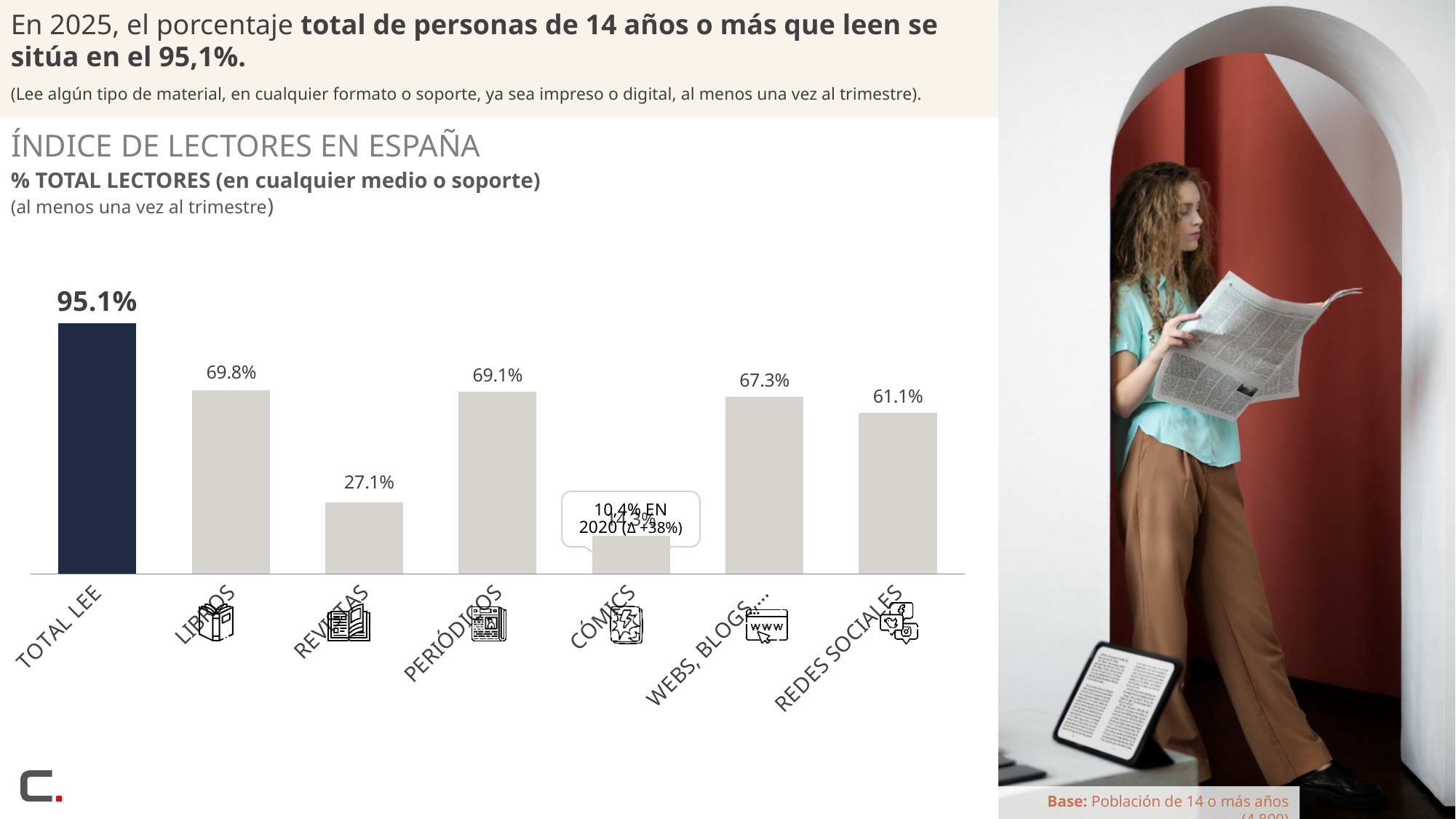
What type of chart is shown on the slide? bar chart Which category has the lowest value? CÓMICS What is the value for REVISTAS? 27.1% How many categories are shown in the chart? 7 What is the value for LIBROS? 69.8% What is the title of the chart? ÍNDICE DE LECTORES EN ESPAÑA What is the value for TOTAL LEE? 95.1% What is the difference between the values for LIBROS and REDES SOCIALES? 8.7% What is the value for PERIÓDICOS? 69.1% Which is larger, the value for WEBS, BLOGS... or the value for REVISTAS? WEBS, BLOGS... Which category has the highest value? TOTAL LEE What is the value for REDES SOCIALES? 61.1%